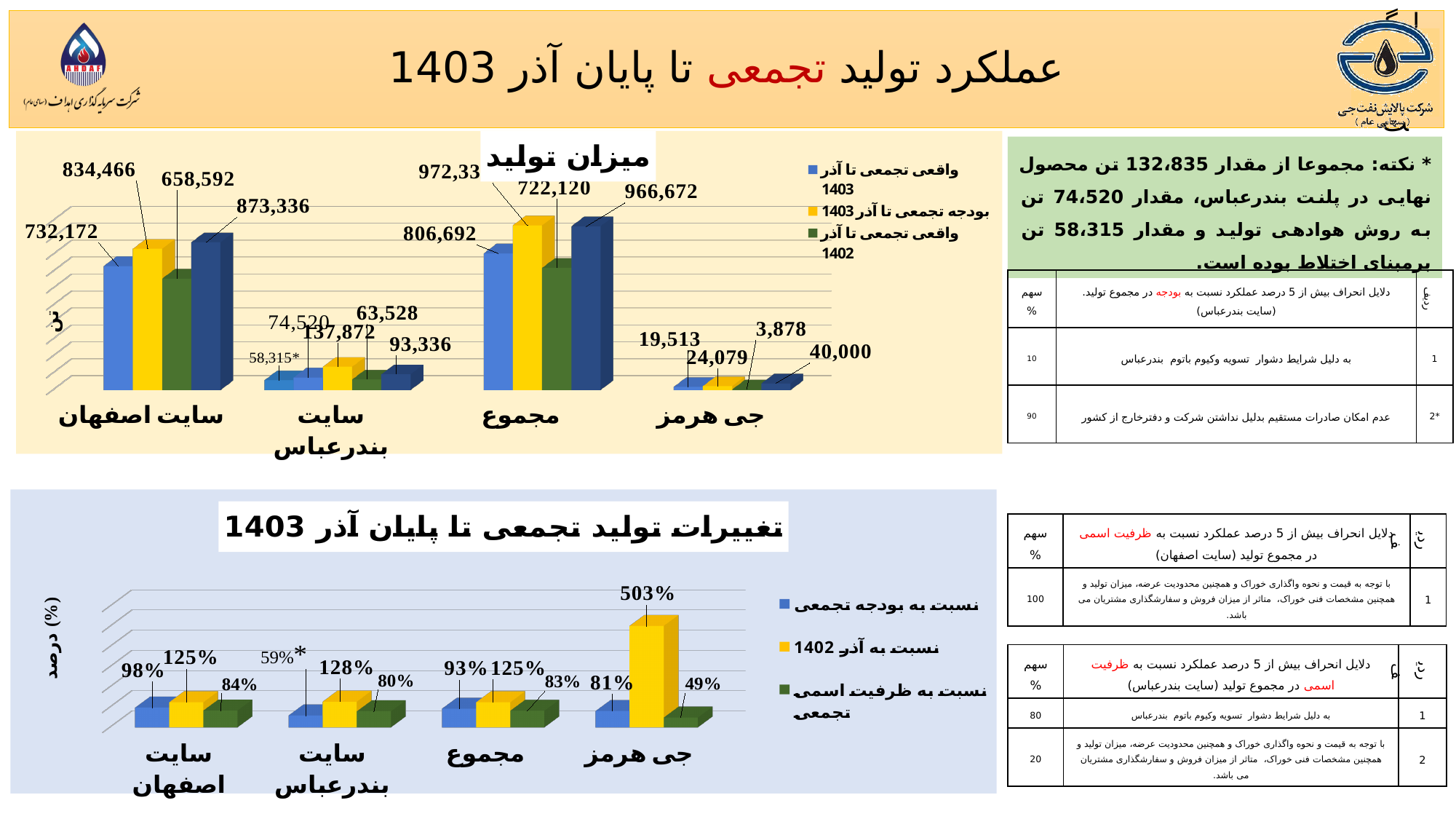
In the bottom chart (تغییرات تولید تجمعی), which category has the highest value for نسبت به آذر 1402? جی هرمز In the top chart (میزان تولید), which category has the lowest values overall? جی هرمز In the bottom chart (تغییرات تولید تجمعی), what is the value of نسبت به ظرفیت اسمی تجمعی for مجموع? 83% How many series does the legend of the bottom chart (تغییرات تولید تجمعی) list? 3 In the top chart (میزان تولید), what is the value of the green series (واقعی تجمعی تا آذر 1402) for جی هرمز? 3,878 In the top chart (میزان تولید), what is the value of the yellow series (بودجه تجمعی تا آذر 1403) for سایت اصفهان? 834,466 In the top chart (میزان تولید), what is the value of the blue series (واقعی تجمعی تا آذر 1403) for مجموع? 806,692 In the bottom chart (تغییرات تولید تجمعی), what is the value of نسبت به آذر 1402 for جی هرمز? 503% In the top chart (میزان تولید), what is the difference between the yellow (بودجه) and blue (واقعی 1403) values for سایت اصفهان? 102,294 In the top chart (میزان تولید), which is larger for جی هرمز: the blue series (واقعی تجمعی تا آذر 1403) or the yellow series (بودجه تجمعی تا آذر 1403)? بودجه تجمعی تا آذر 1403 (24,079) How many categories are shown on the x axis of the top chart (میزان تولید)? 4 What type of chart is the bottom chart (تغییرات تولید تجمعی تا پایان آذر 1403)? Bar chart